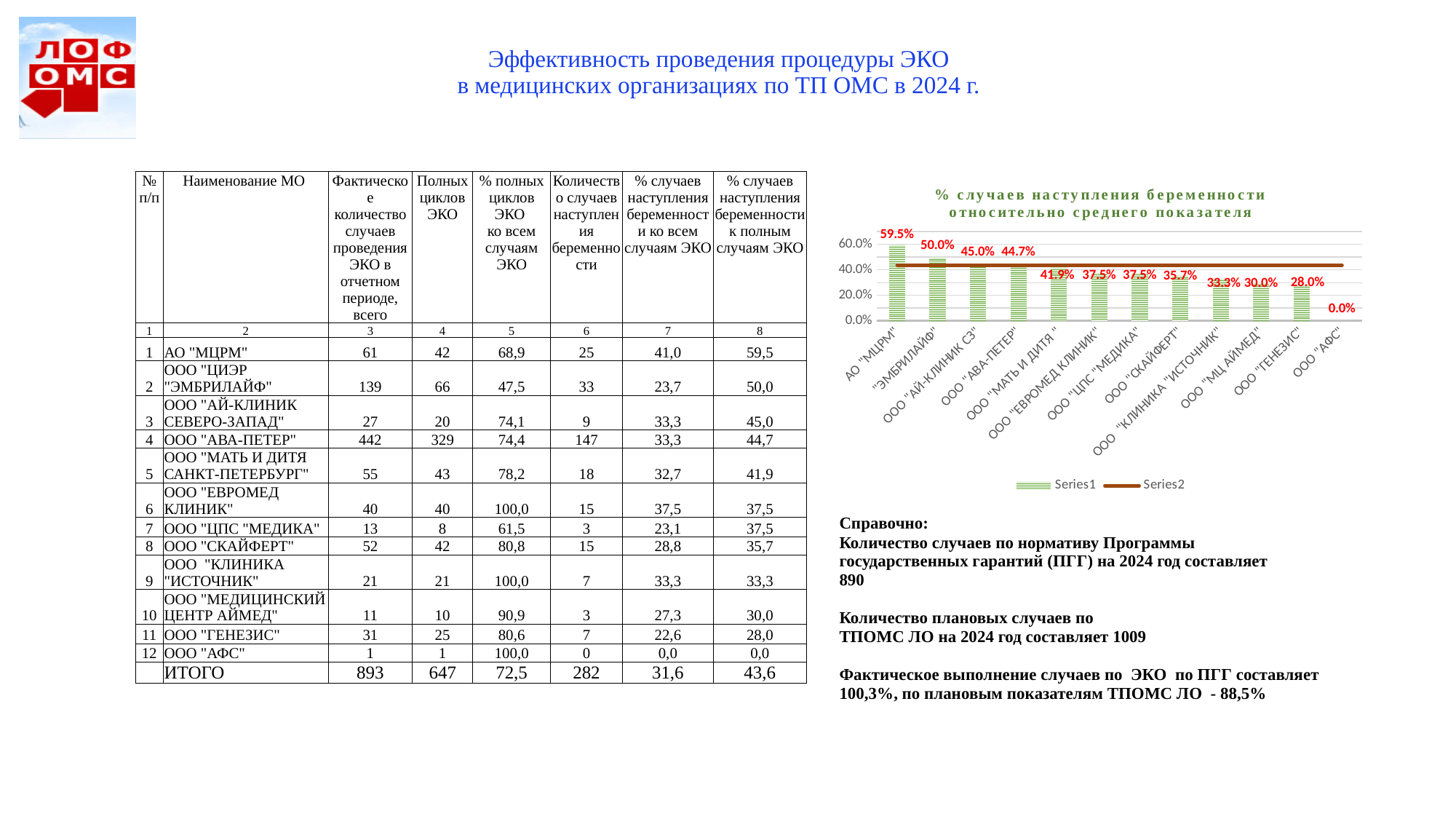
What is the title of the chart? % случаев наступления беременности относительно среднего показателя Which category has the highest value in the chart? АО "МЦРМ" What is the value for АО "МЦРМ" in the chart? 59.5% Which has a larger value, ООО "АЙ-КЛИНИК СЗ" or ООО "МЦ АЙМЕД"? ООО "АЙ-КЛИНИК СЗ" What type of chart is shown on the slide? combination bar and line chart Which category has the lowest value in the chart? ООО "АФС" What is the value for ООО "АВА-ПЕТЕР" in the chart? 44.7% How many categories are shown on the x axis of the chart? 12 How many series does the chart legend list? 2 What is the difference between the values for АО "МЦРМ" and "ЭМБРИЛАЙФ"? 9.5% Is the value for ООО "СКАЙФЕРТ" greater or less than 40.0%? less What is the value for ООО "ГЕНЕЗИС" in the chart? 28.0%